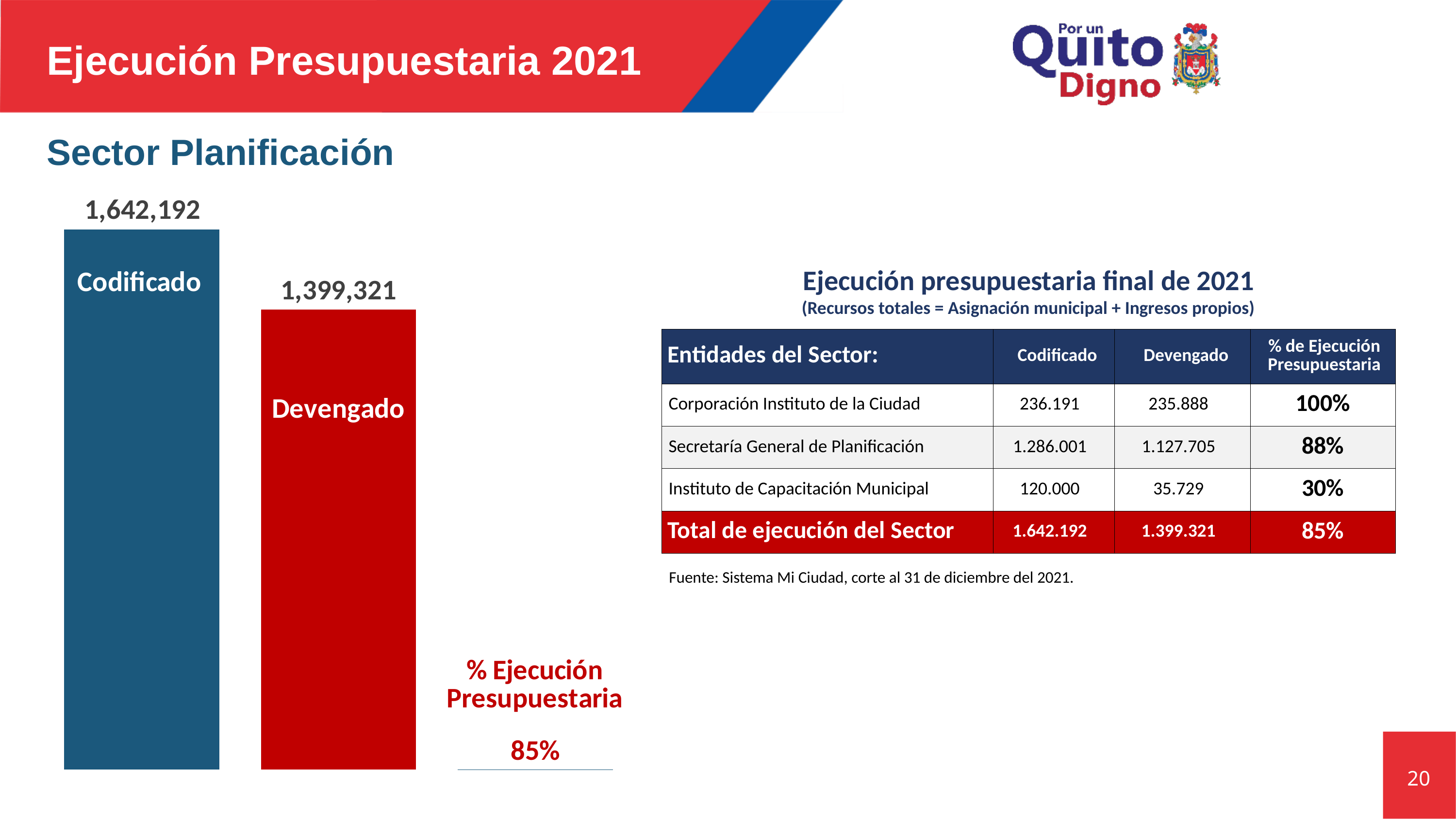
What is the value of the Devengado bar in the bar chart? 1,399,321 What colour is the Devengado bar in the chart? Red What colour is the Codificado bar in the chart? Blue What kind of chart is shown on the left of the slide? Bar chart How many bars are plotted in the bar chart? 2 What is the difference between the Codificado and Devengado values in the bar chart? 242,871 What is the value of the Codificado bar in the bar chart? 1,642,192 Which bar in the chart is the lowest? Devengado Which is larger in the bar chart, Codificado or Devengado? Codificado Which bar in the chart is the highest? Codificado What percentage is shown as the % Ejecución Presupuestaria next to the bar chart? 85%